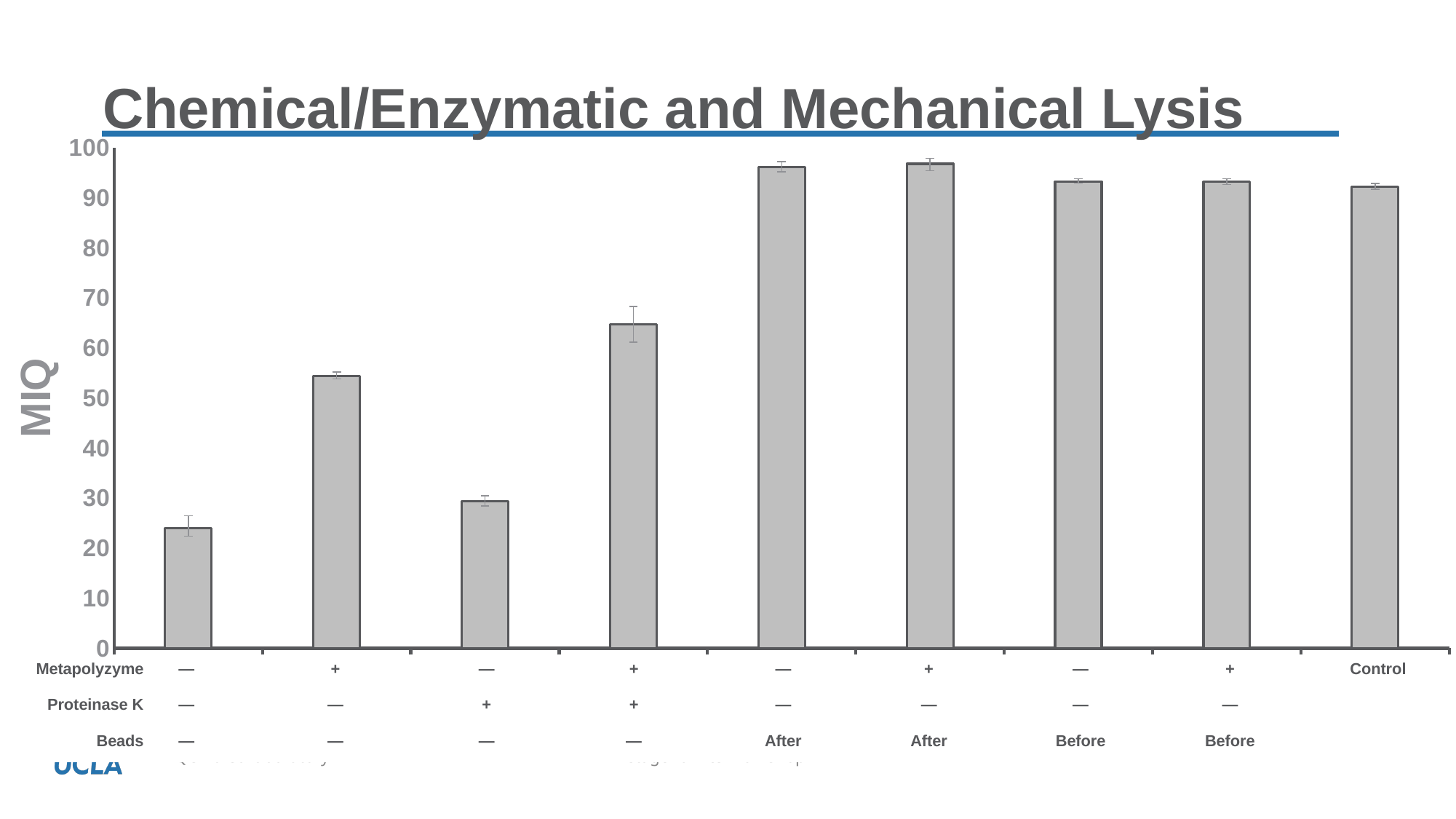
Is the value for the bar with Metapolyzyme +, Proteinase K +, Beads — greater or less than 60? greater Which is larger: the MIQ for the Beads After bar with Metapolyzyme —, or the MIQ for the first bar with all conditions —? the Beads After bar with Metapolyzyme — What kind of chart is shown on the slide? bar chart How many bars are plotted in the chart? 9 Is the value for the bar with Metapolyzyme +, Proteinase K —, Beads — greater or less than 50? greater Is the value for the first bar from the left (Metapolyzyme —, Proteinase K —, Beads —) greater or less than 30? less Which bar has the lowest MIQ value? the first bar (Metapolyzyme —, Proteinase K —, Beads —) What is the title of the slide's chart? Chemical/Enzymatic and Mechanical Lysis What is the label on the y axis of the chart? MIQ Which is larger: the MIQ for Metapolyzyme + with Proteinase K — and Beads —, or the MIQ for Metapolyzyme + with Proteinase K + and Beads —? Metapolyzyme + with Proteinase K + and Beads —